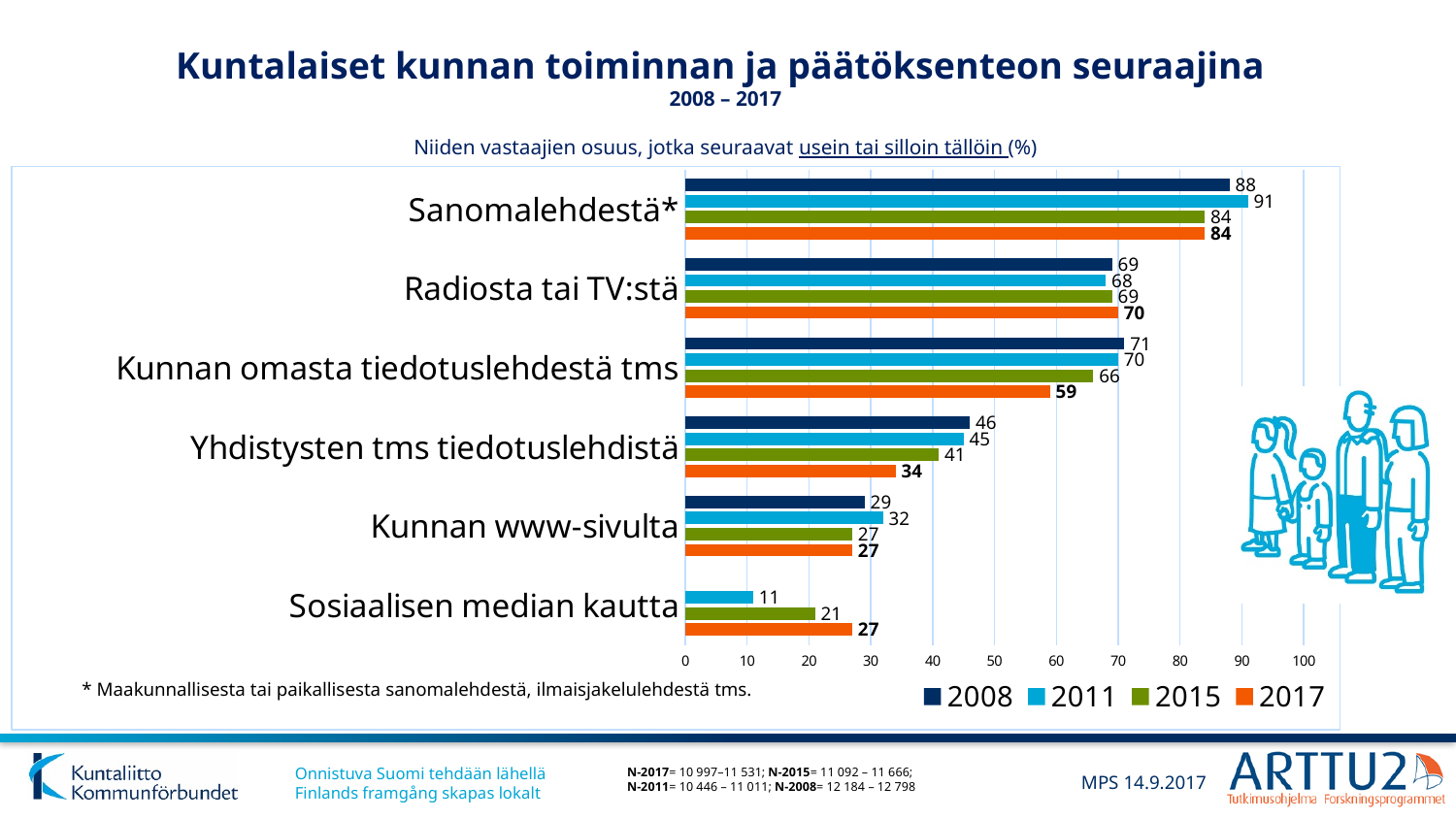
How many categories are shown on the chart? 6 What is the value for Sosiaalisen median kautta in 2011? 11 How many series does the legend list? 4 What is the difference between the 2008 and 2017 values for Yhdistysten tms tiedotuslehdistä? 12 Do the values for Sosiaalisen median kautta rise or fall from 2011 to 2017? rise What kind of chart is shown on the slide? bar chart Which year is shown in orange in the legend? 2017 Which is larger for Kunnan www-sivulta: the 2008 value or the 2011 value? 2011 What is the value for Sanomalehdestä* in 2011? 91 Which category has the highest value in 2017? Sanomalehdestä* Which category has the lowest value in 2011? Sosiaalisen median kautta What is the value for Kunnan omasta tiedotuslehdestä tms in 2017? 59